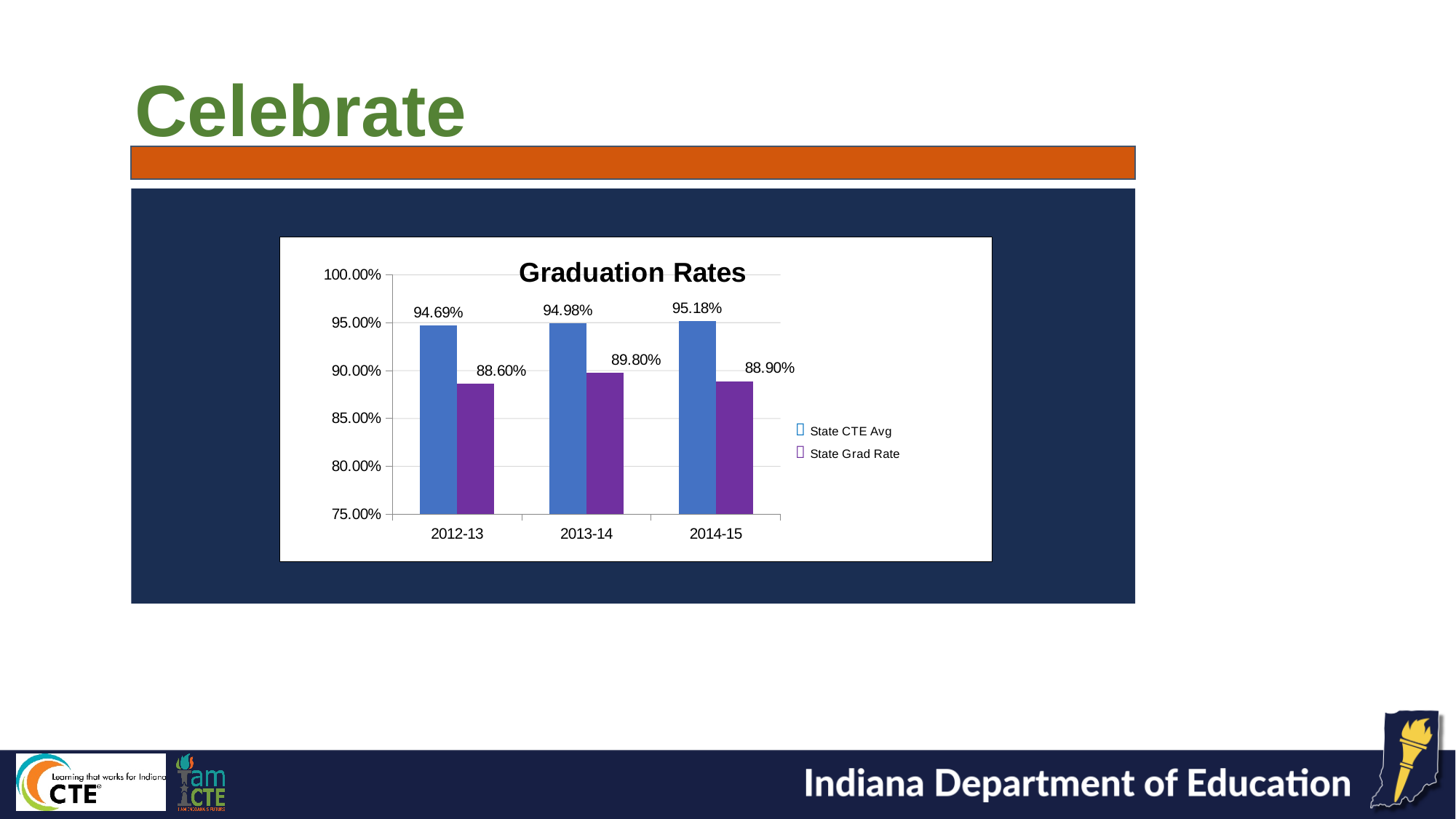
What is the State CTE Avg graduation rate for 2012-13? 94.69% Does the State CTE Avg rise or fall from 2012-13 to 2014-15? Rise What is the State Grad Rate for 2013-14? 89.80% How many years are shown on the x axis? 3 What is the State Grad Rate for 2012-13? 88.60% In which year is the State Grad Rate lowest? 2012-13 Which is larger in 2013-14, the State CTE Avg or the State Grad Rate? State CTE Avg What is the difference between the State CTE Avg and the State Grad Rate in 2014-15? 6.28% In which year is the State CTE Avg highest? 2014-15 What kind of chart is shown? Bar chart How many series does the legend list? 2 What is the State CTE Avg graduation rate for 2014-15? 95.18%